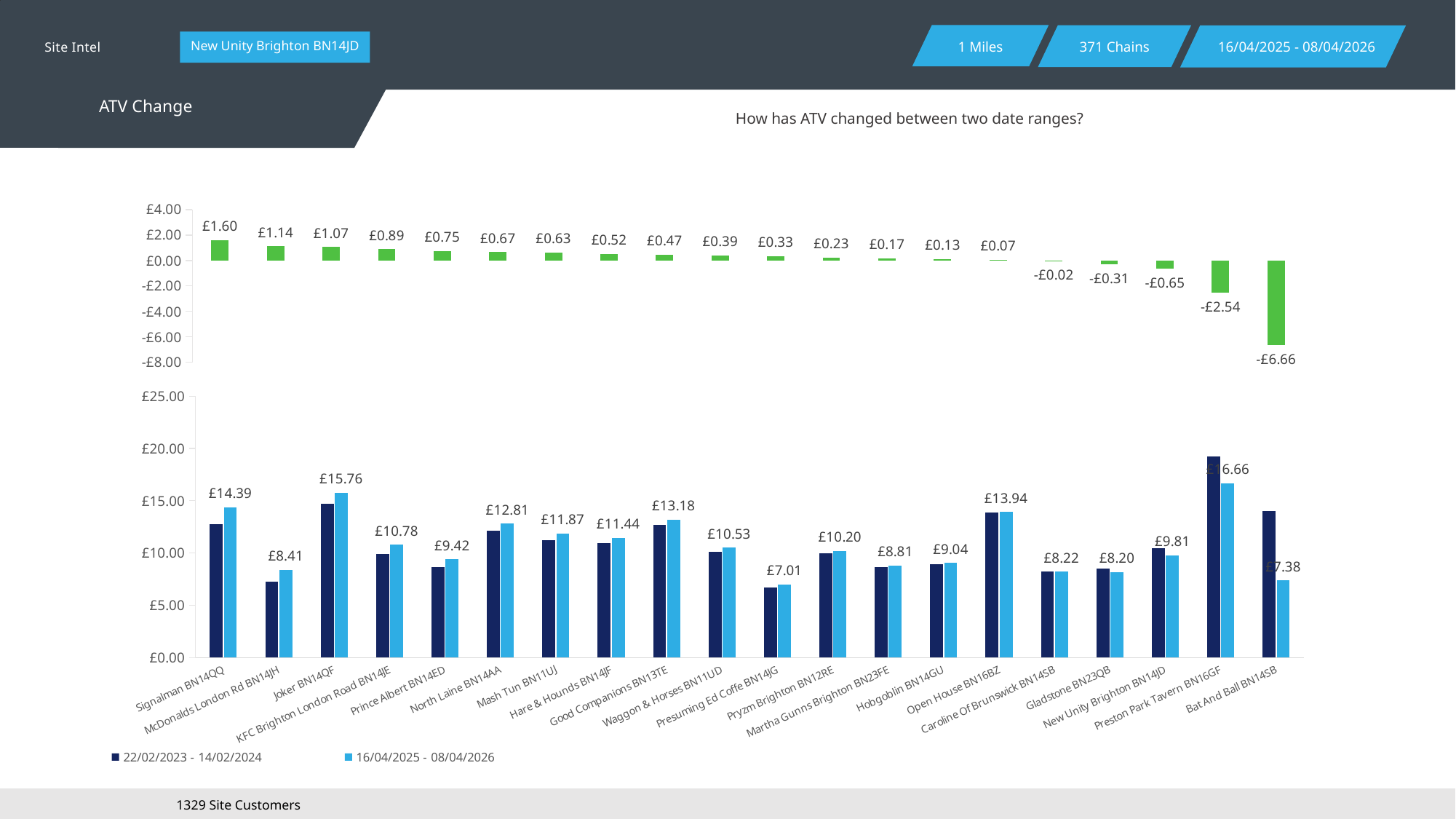
In the bottom chart, is the 22/02/2023 - 14/02/2024 value for Preston Park Tavern BN16GF greater or less than £15.00? greater In the bottom chart, which is larger for the 16/04/2025 - 08/04/2026 period: Joker BN14QF or Open House BN16BZ? Joker BN14QF In the bottom chart, what is the ATV for Preston Park Tavern BN16GF in the 16/04/2025 - 08/04/2026 period? £16.66 In the bottom chart, how many series does the legend list? 2 In the top chart, do the values rise or fall moving left to right along the x axis? fall How many venues are shown on the x axis of the bottom chart? 20 In the top chart, what is the difference between the ATV change for Joker BN14QF and KFC Brighton London Road BN14JE? £0.18 In the bottom chart, what is the ATV for Presuming Ed Coffe BN14JG in the 16/04/2025 - 08/04/2026 period? £7.01 In the top chart, what is the ATV change for Bat And Ball BN14SB? -£6.66 In the top chart, what is the ATV change for Signalman BN14QQ? £1.60 In the top chart, which venue has the highest ATV change? Signalman BN14QQ In the top chart, which venue has the lowest ATV change? Bat And Ball BN14SB